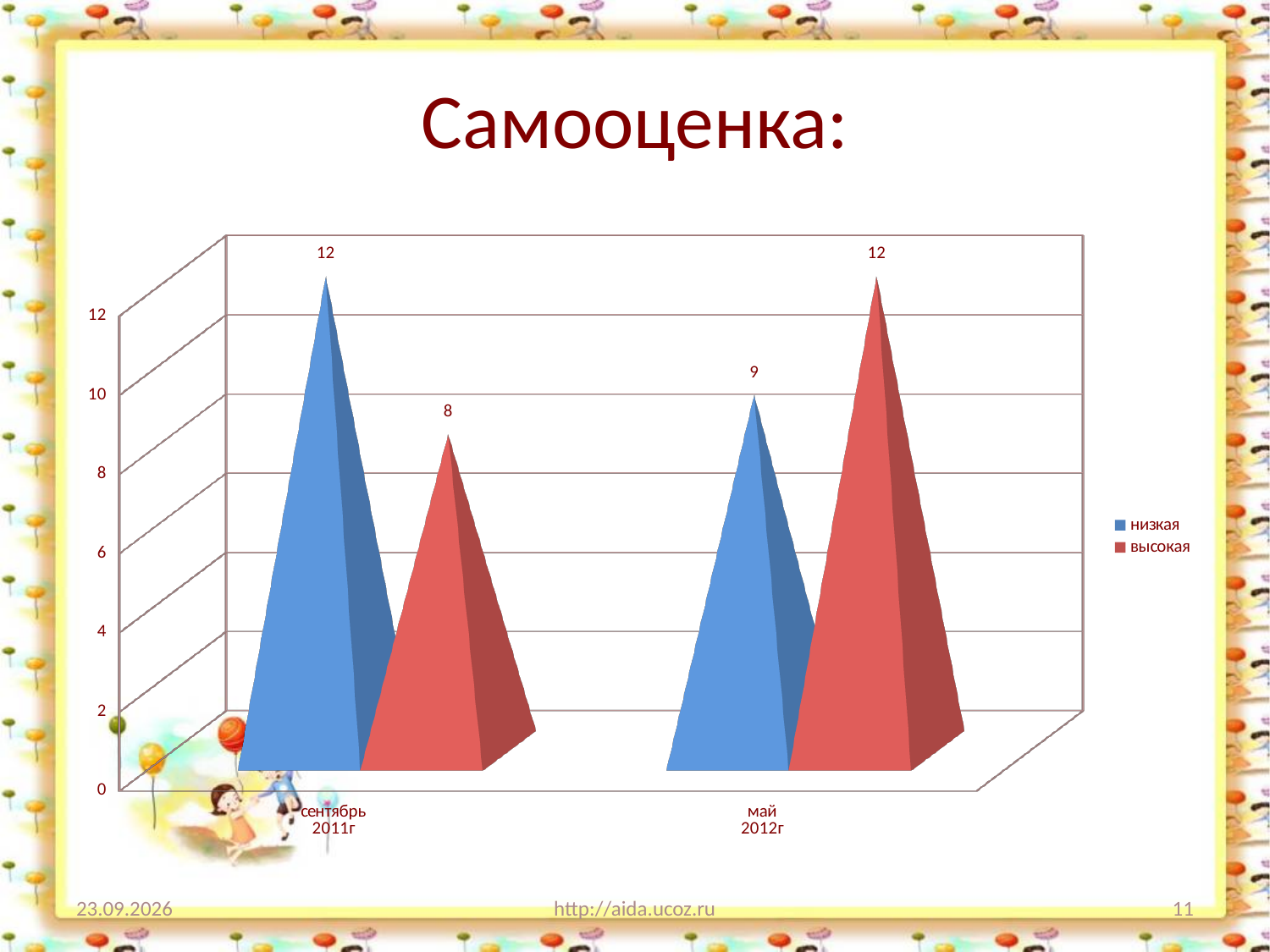
What is the value for высокая in сентябрь 2011г? 8 Which is larger in май 2012г, низкая or высокая? высокая Which category has the highest value for высокая? май 2012г What is the difference between высокая and низкая in май 2012г? 3 Which category has the lowest value for высокая? сентябрь 2011г What is the value for высокая in май 2012г? 12 What is the value for низкая in май 2012г? 9 How many series does the legend list? 2 What kind of chart is shown on the slide? bar chart How many categories are shown on the x axis? 2 What is the value for низкая in сентябрь 2011г? 12 What is the difference between низкая and высокая in сентябрь 2011г? 4